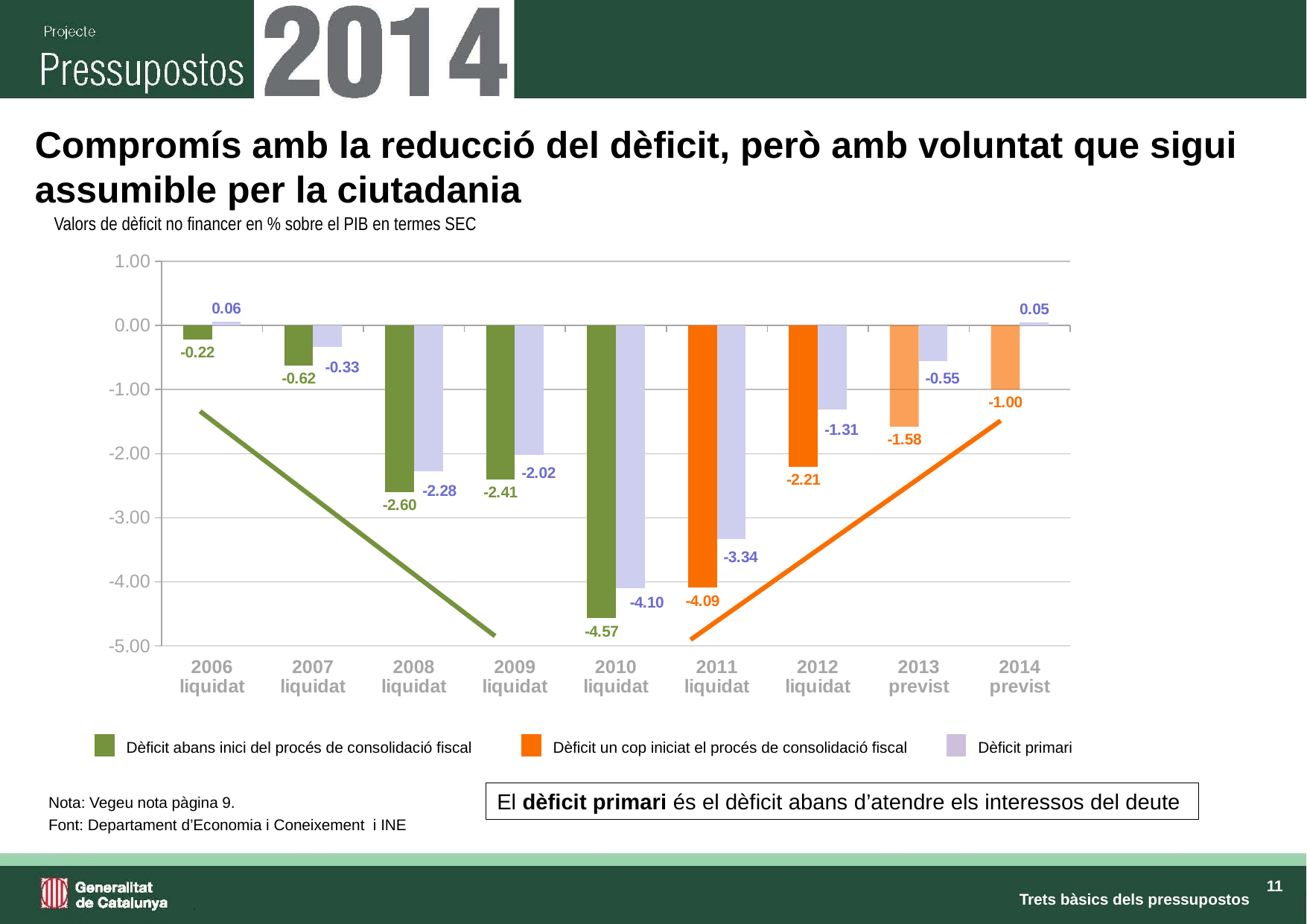
What is the deficit value (Dèficit un cop iniciat el procés de consolidació fiscal) for 2011 liquidat? -4.09 What kind of chart is shown on the slide? Bar chart Which year has the less negative (higher) deficit value, 2008 liquidat or 2009 liquidat? 2009 liquidat Which year has the highest Dèficit primari value? 2006 liquidat Which year has the most negative deficit value (green/orange bars) in the chart? 2010 liquidat From 2011 liquidat to 2014 previst, do the deficit values (orange bars) rise or fall? Rise How many years (categories) are shown on the x axis of the chart? 9 What is the Dèficit primari value for 2010 liquidat? -4.10 What is the difference between the deficit (-4.57) and the Dèficit primari (-4.10) for 2010 liquidat? 0.47 What is the difference between the deficit (-2.21) and the Dèficit primari (-1.31) for 2012 liquidat? 0.90 How many series does the chart legend list? 3 What is the deficit value shown for 2014 previst (orange bar)? -1.00